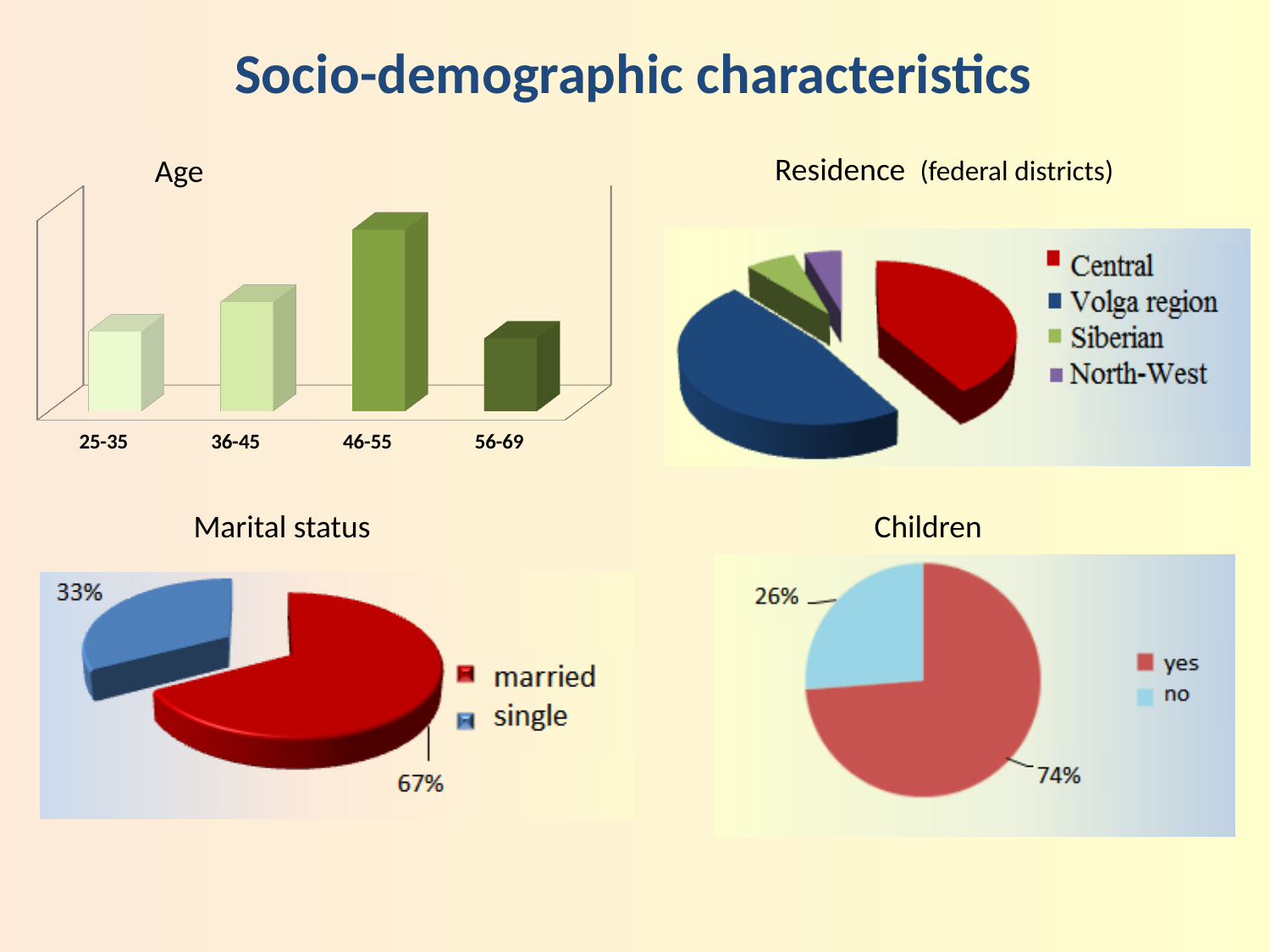
In the Marital status pie chart, what is the difference between the married and single shares? 34% In the Children pie chart, what is the difference between the yes and no shares? 48% In the Marital status pie chart, what percentage is married? 67% How many age groups are shown in the Age chart? 4 In the Marital status pie chart, what percentage is single? 33% In the Age chart, which bar is taller: 36-45 or 46-55? 46-55 In the Residence (federal districts) pie chart, which district has the largest slice? Volga region In the Residence (federal districts) pie chart, which district has the smallest slice? North-West What type of chart is the Age chart? bar chart How many districts does the legend of the Residence (federal districts) chart list? 4 In the Children pie chart, what percentage answered yes? 74% In the Age chart, which age group has the tallest bar? 46-55